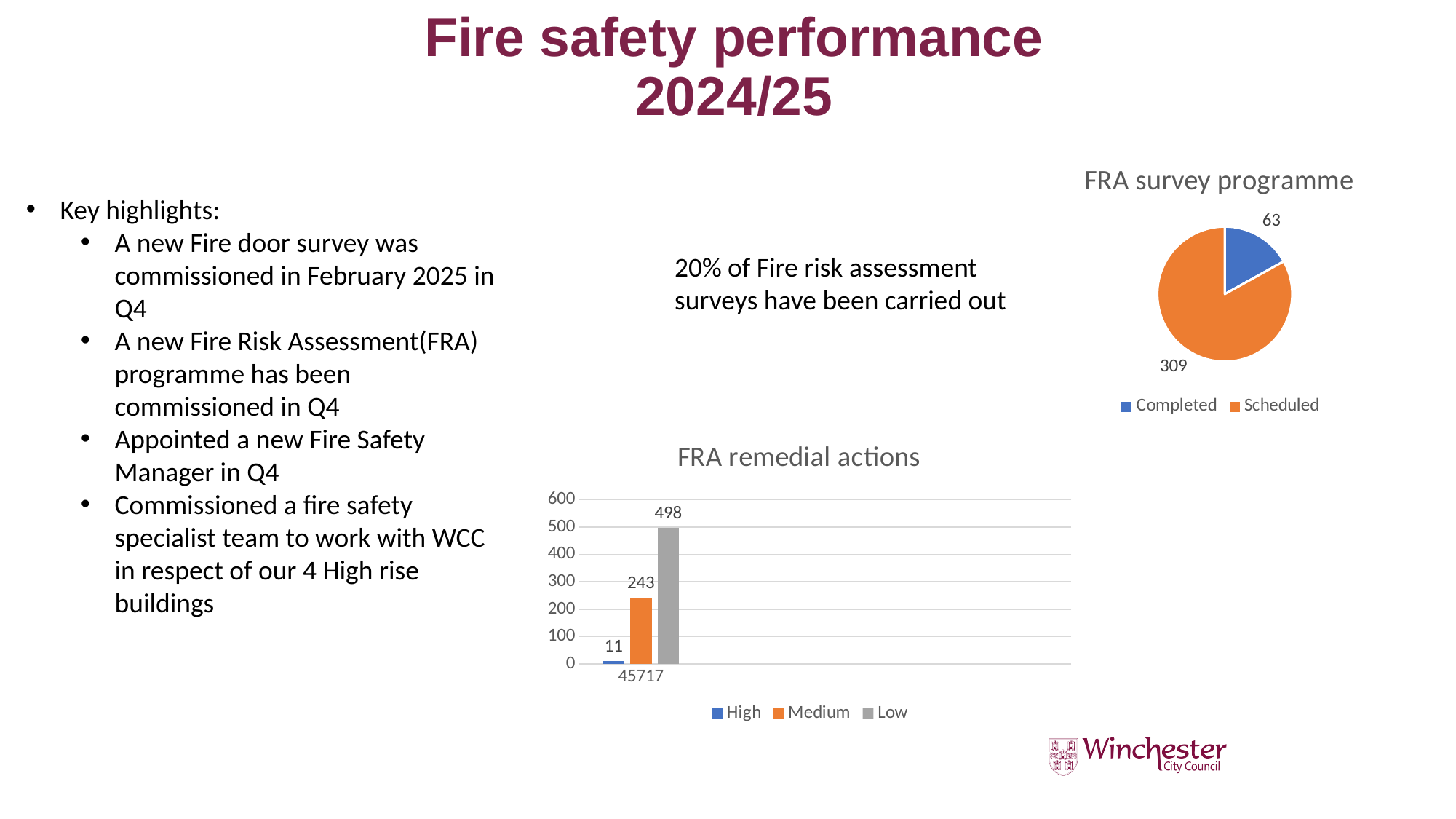
In the FRA remedial actions chart, which series has the lowest value? High In the FRA survey programme chart, what is the value for Completed? 63 What kind of chart is the FRA remedial actions chart? Bar chart In the FRA remedial actions chart, what is the value for Medium? 243 In the FRA remedial actions chart, which series has the highest value? Low In the FRA remedial actions chart, what is the value for High? 11 In the FRA remedial actions chart, how many series does the legend list? 3 In the FRA survey programme chart, what is the value for Scheduled? 309 In the FRA remedial actions chart, what is the value for Low? 498 What kind of chart is the FRA survey programme chart? Pie chart In the FRA survey programme chart, which slice is larger, Completed or Scheduled? Scheduled In the FRA remedial actions chart, what is the difference between the Low and Medium values? 255